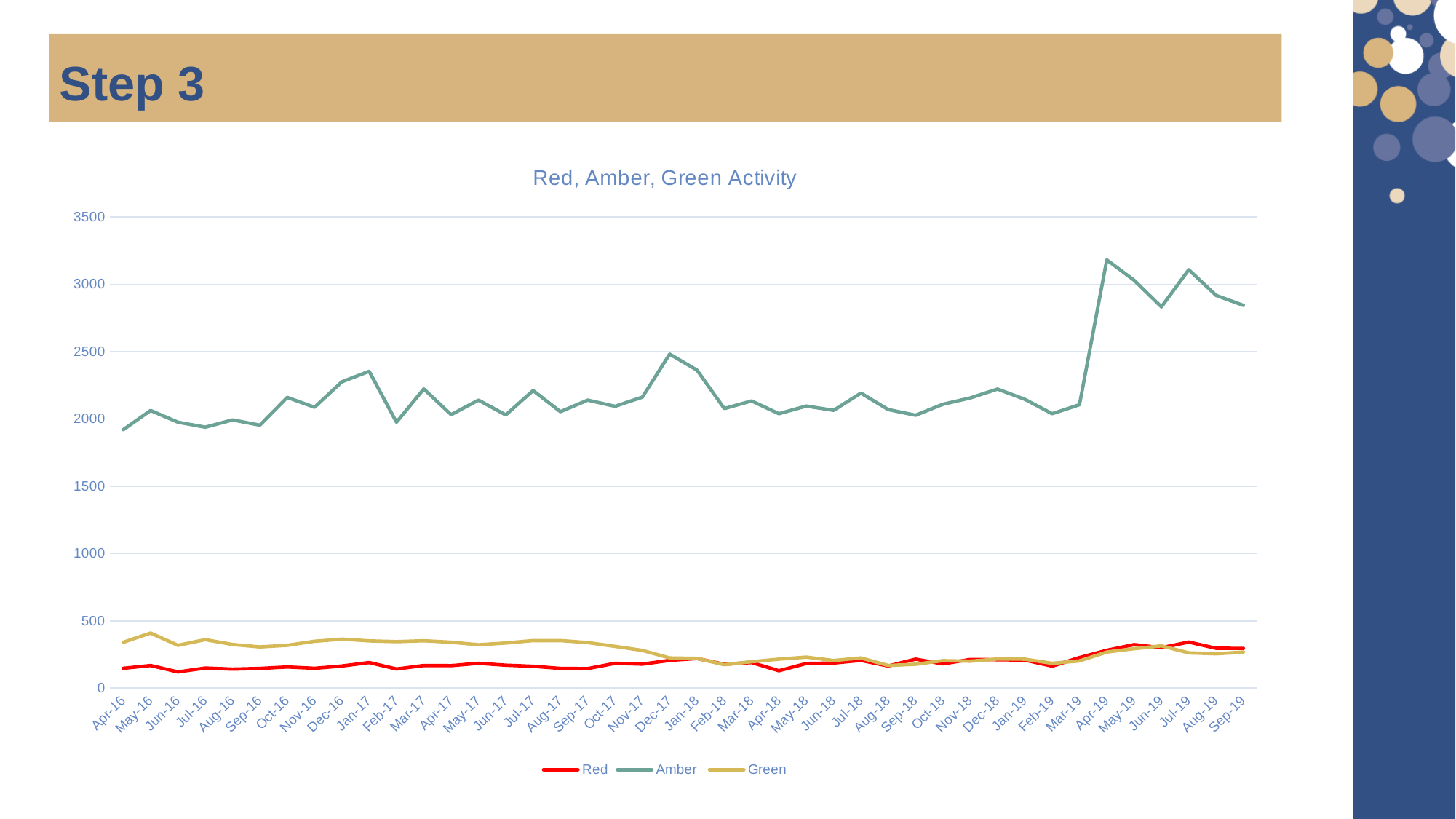
How many monthly points are plotted along the x axis, from Apr-16 to Sep-19? 42 In which month does the Green series reach its highest value? May-16 Is the Amber value for Apr-19 greater or less than 3000? greater Does the Amber series rise or fall between Mar-19 and Apr-19? rise Is the Amber value for Apr-16 greater or less than 2000? less Which series has the larger value in Sep-19, Amber or Green? Amber What is the title of the chart? Red, Amber, Green Activity In which month does the Amber series reach its highest value? Apr-19 What kind of chart is shown on the slide? line chart How many series does the legend list? 3 In which month is the Amber series at its lowest value? Apr-16 Is the Green value for May-16 greater or less than 500? less